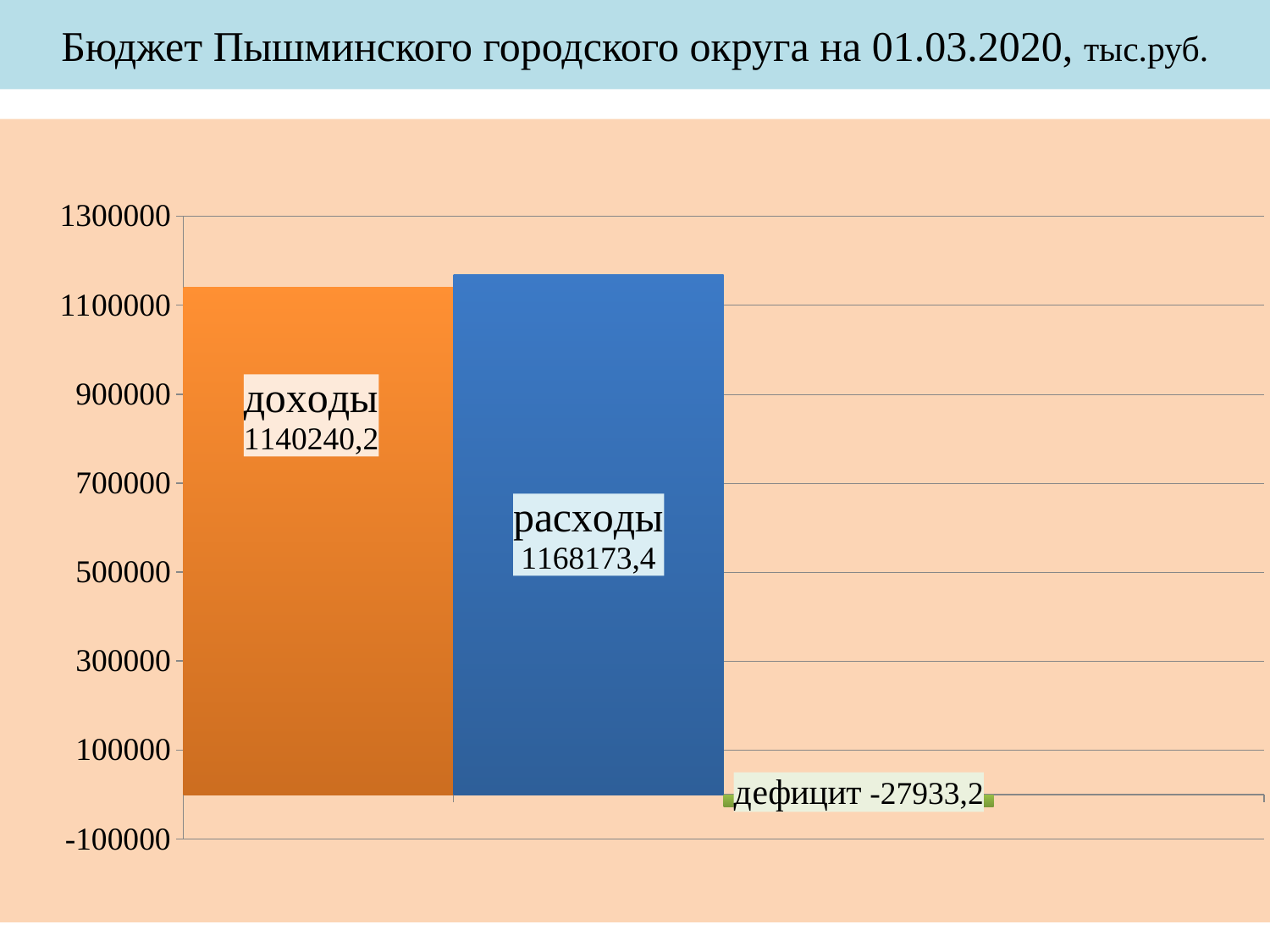
Which is larger, доходы or расходы? расходы Is the value for доходы greater or less than 1100000? greater What is the value for дефицит? -27933,2 How many categories are plotted in the chart? 3 What is the value for расходы? 1168173,4 What is the title of the slide? Бюджет Пышминского городского округа на 01.03.2020, тыс.руб. What is the difference between расходы and доходы? 27933,2 Which category has the highest value? расходы What is the value for доходы? 1140240,2 What kind of chart is shown on the slide? bar chart Is the value for дефицит greater or less than 100000? less Which category has the lowest value? дефицит